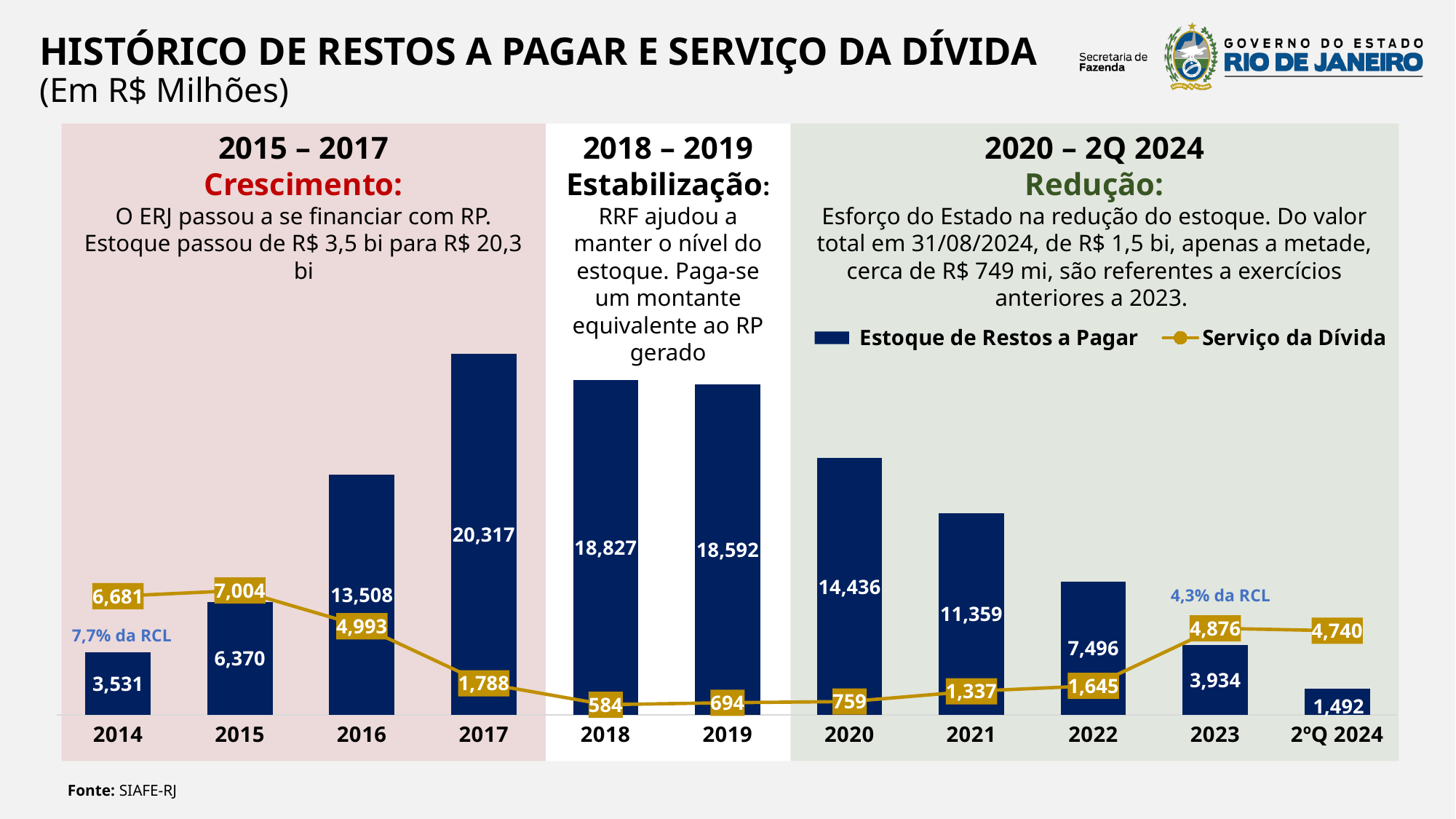
How many series does the legend list? 2 What is the difference between Estoque de Restos a Pagar in 2018 and 2019? 235 Which year has the highest Estoque de Restos a Pagar? 2017 What is the value of Estoque de Restos a Pagar for 2ºQ 2024? 1,492 What kind of chart is used to show Estoque de Restos a Pagar? Bar chart How many periods are shown on the x axis of the chart? 11 What is the source cited for the chart? SIAFE-RJ What is the value of Serviço da Dívida for 2018? 584 What is the value of Estoque de Restos a Pagar for 2017? 20,317 Does Estoque de Restos a Pagar rise or fall from 2020 to 2ºQ 2024? Fall Which year has the lowest Serviço da Dívida? 2018 Which is larger in 2023: Estoque de Restos a Pagar or Serviço da Dívida? Serviço da Dívida